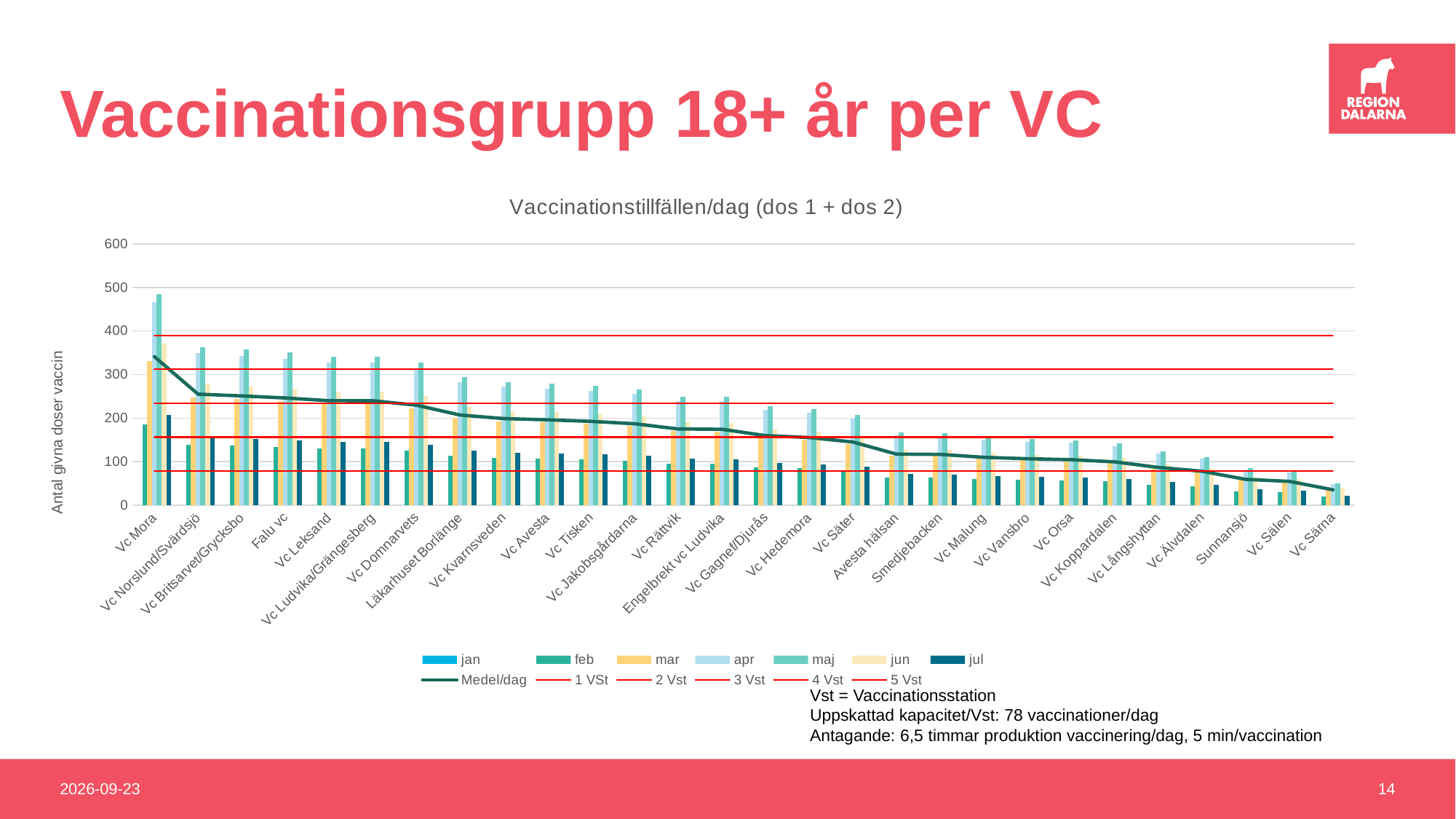
Which is larger, the maj value for Vc Mora or the maj value for Vc Norslund/Svärdsjö? Vc Mora What is the title of the chart? Vaccinationstillfällen/dag (dos 1 + dos 2) How many vaccination centres (categories) are shown on the x axis? 28 Which vaccination centre has the highest maj bar? Vc Mora Does the Medel/dag line rise or fall from left to right across the x axis? fall What kind of chart is shown on the slide? Bar chart with a line Is the Medel/dag value for Vc Mora greater or less than 300? greater What is the label on the y axis? Antal givna doser vaccin Is the maj value for Vc Mora greater or less than 400? greater How many entries does the legend list? 13 Is the maj value for Vc Särna greater or less than 100? less Which vaccination centre has the lowest Medel/dag value? Vc Särna